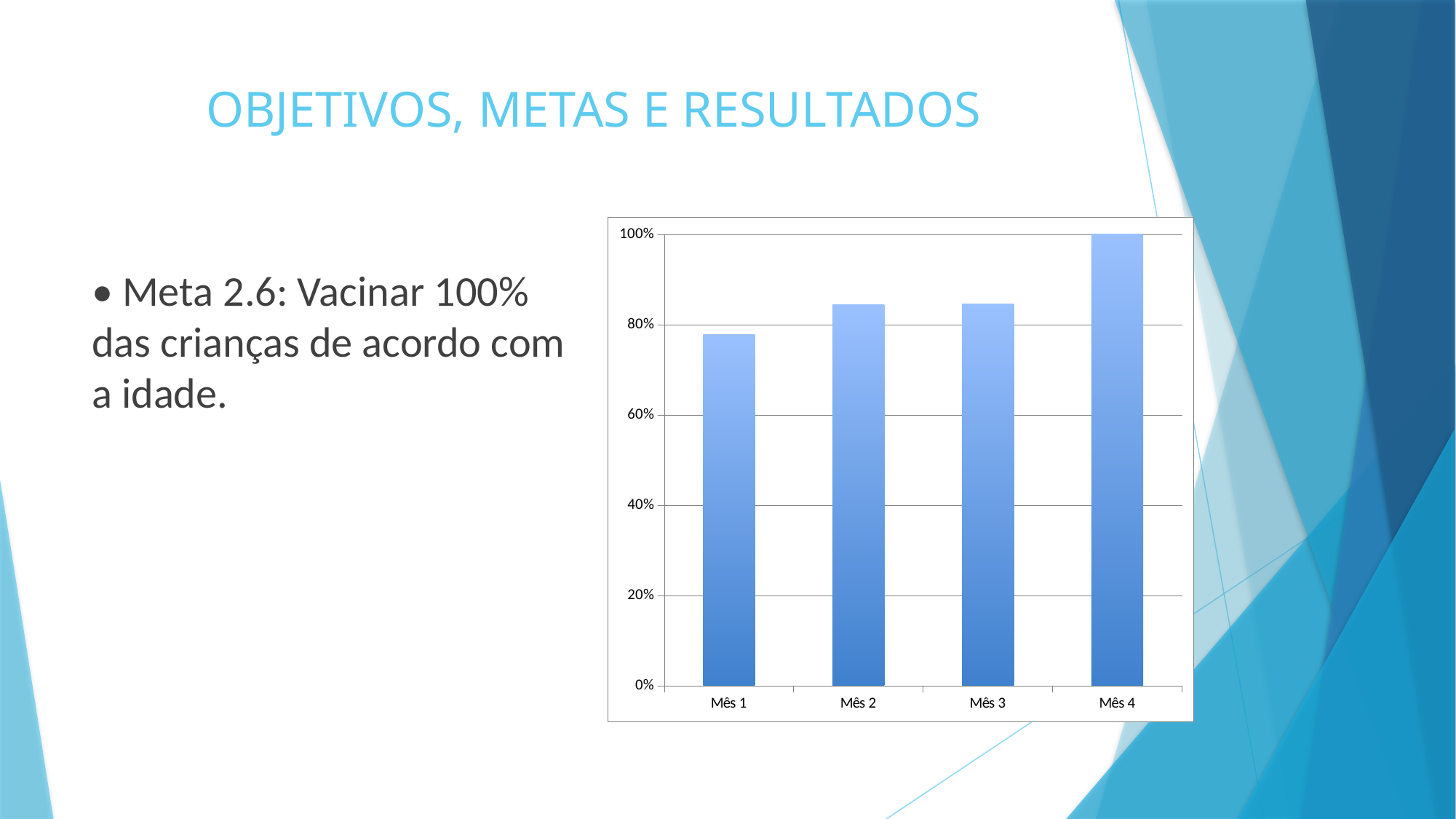
Is the value for Mês 2 greater or less than 80%? greater Which is larger, the value for Mês 1 or the value for Mês 2? Mês 2 What is the highest value shown on the chart's vertical axis? 100% Do the values generally rise or fall from Mês 1 to Mês 4? rise What is the value for Mês 4 in the chart? 100% Is the value for Mês 3 greater or less than 60%? greater How many categories are shown on the x axis of the chart? 4 Which is larger, the value for Mês 1 or the value for Mês 4? Mês 4 Which month has the lowest bar in the chart? Mês 1 What kind of chart is shown on the slide? bar chart Which month has the highest bar in the chart? Mês 4 Is the value for Mês 1 greater or less than 80%? less